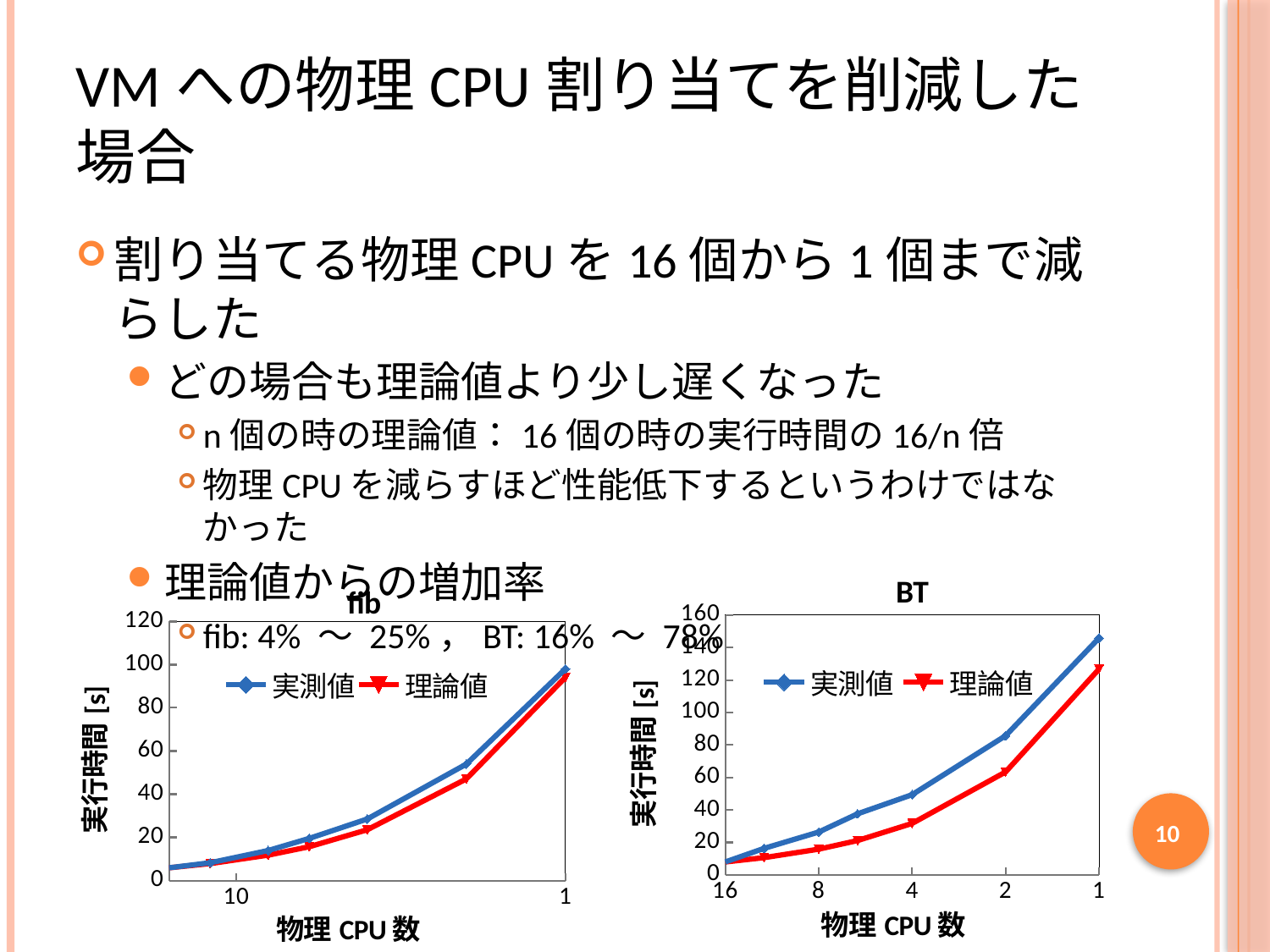
In the BT chart, is the 理論値 value at 2 physical CPUs greater or less than 80? less In the BT chart, at which number of physical CPUs is the 実測値 value highest? 1 What is the y-axis label of the fib chart? 実行時間 [s] What are the legend entries of the BT chart? 実測値, 理論値 What kind of chart is the BT chart? line chart In the BT chart, is the 実測値 value at 1 physical CPU greater or less than 140? greater In the BT chart, does the 実測値 line rise or fall as the number of physical CPUs goes from 16 to 1 along the x axis? rise In the BT chart, which series has the larger value at 2 physical CPUs, 実測値 or 理論値? 実測値 How many series does the legend of the fib chart list? 2 In the fib chart, is the 実測値 value at 1 physical CPU greater or less than 80? greater In the BT chart, which series has the larger value at 4 physical CPUs, 実測値 or 理論値? 実測値